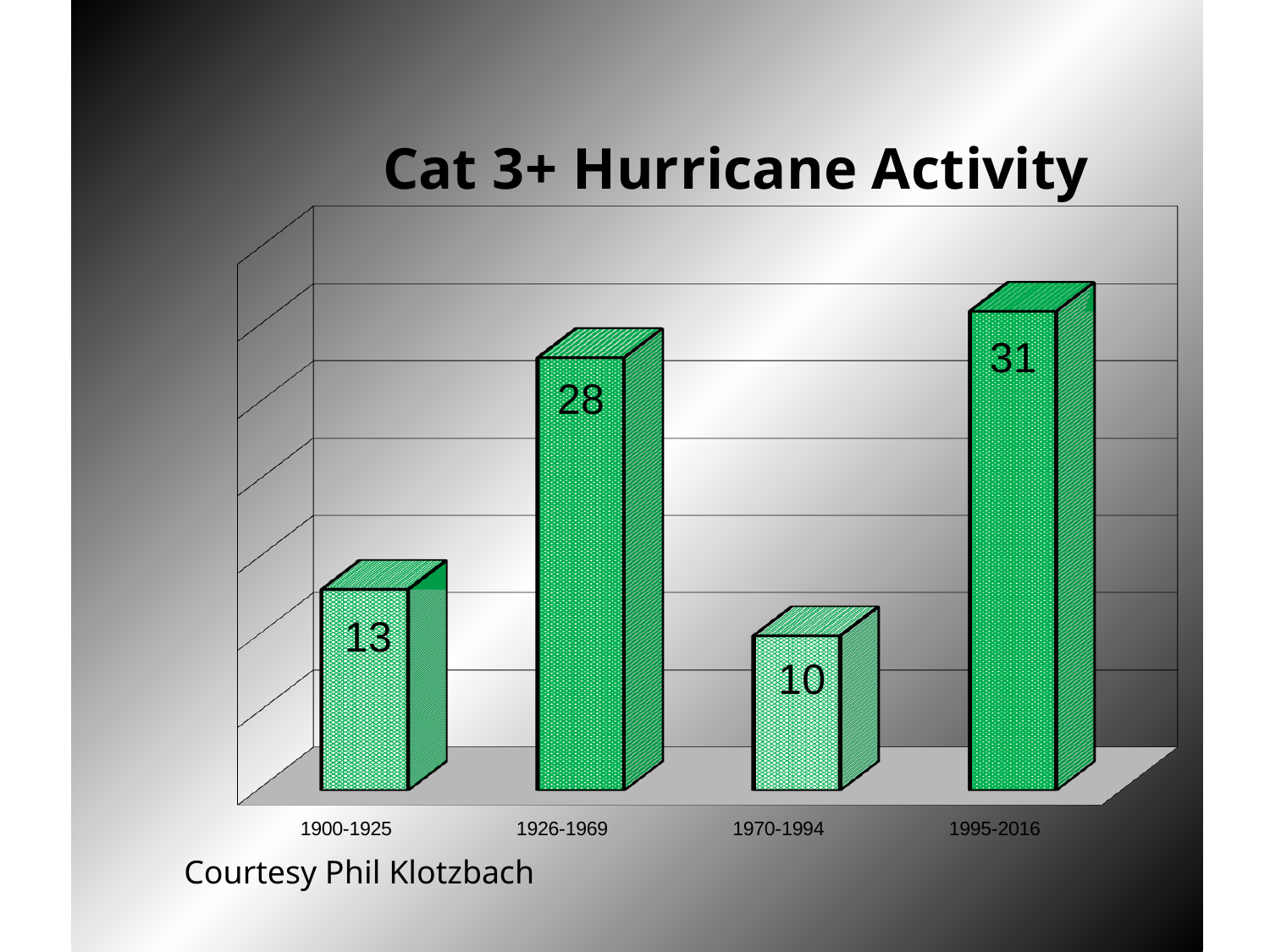
What is the value for 1900-1925? 13 Which period has the highest value? 1995-2016 What is the value for 1926-1969? 28 Which is larger, the value for 1900-1925 or the value for 1970-1994? 1900-1925 What is the value for 1995-2016? 31 What is the value for 1970-1994? 10 What kind of chart is this? bar chart What is the difference between the values for 1995-2016 and 1926-1969? 3 How many periods are shown on the chart? 4 What is the difference between the values for 1900-1925 and 1970-1994? 3 Which period has the lowest value? 1970-1994 What is the title of the chart? Cat 3+ Hurricane Activity